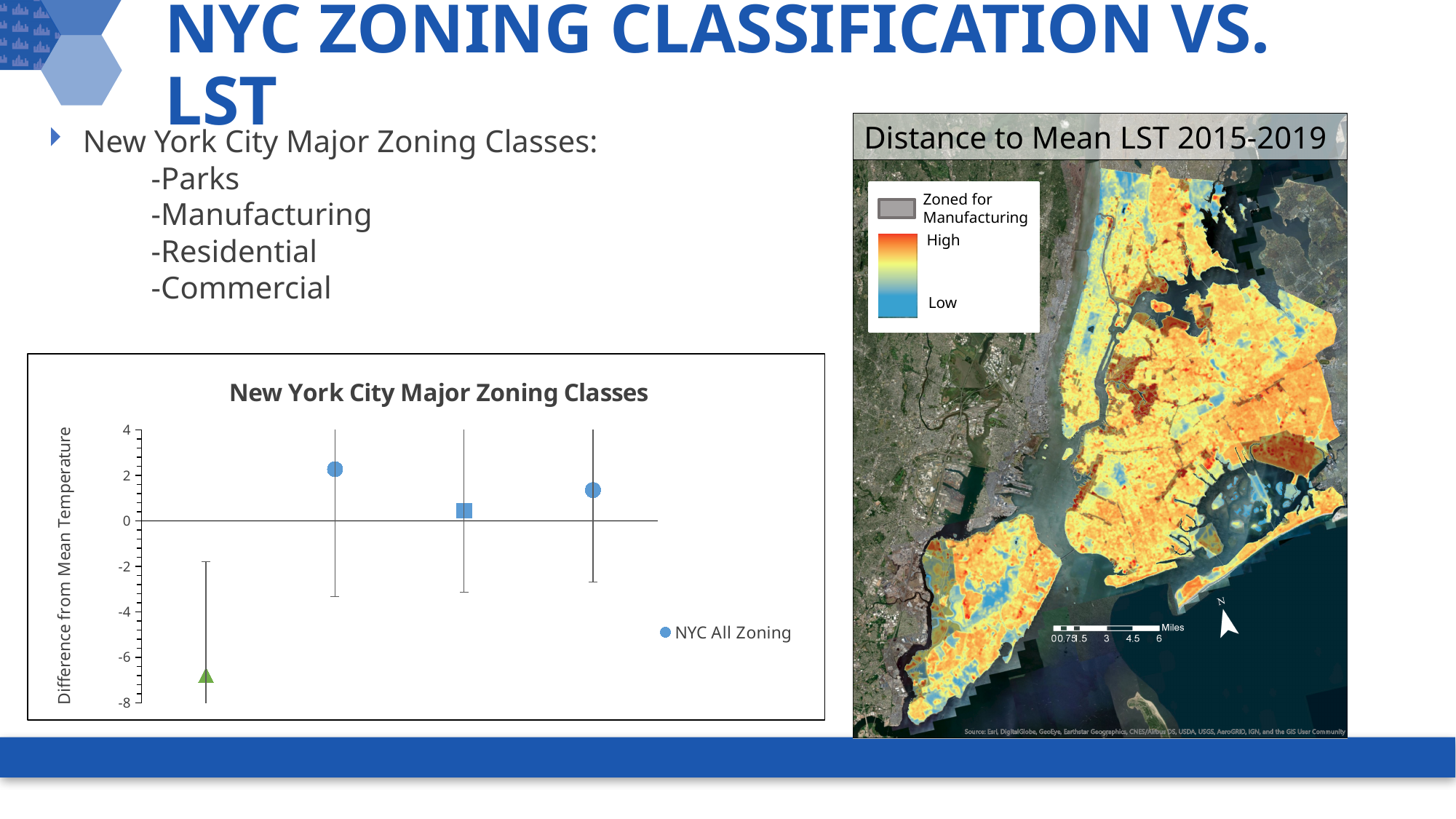
What kind of chart is the New York City Major Zoning Classes chart? scatter chart On the New York City Major Zoning Classes chart, which marker has the lowest value? the green triangle How many data points are plotted on the New York City Major Zoning Classes chart? 4 What is the lowest tick value shown on the vertical axis of the New York City Major Zoning Classes chart? -8 What is the title of the chart on the left side of the slide? New York City Major Zoning Classes On the New York City Major Zoning Classes chart, is the value of the blue square marker greater or less than 0? greater How many series does the legend of the New York City Major Zoning Classes chart list? 1 On the New York City Major Zoning Classes chart, is the value of the rightmost blue circle marker greater or less than 2? less On the New York City Major Zoning Classes chart, is the value of the leftmost blue circle marker greater or less than 2? greater What is the label of the vertical axis on the New York City Major Zoning Classes chart? Difference from Mean Temperature On the New York City Major Zoning Classes chart, which has the larger value: the leftmost blue circle or the rightmost blue circle? the leftmost blue circle